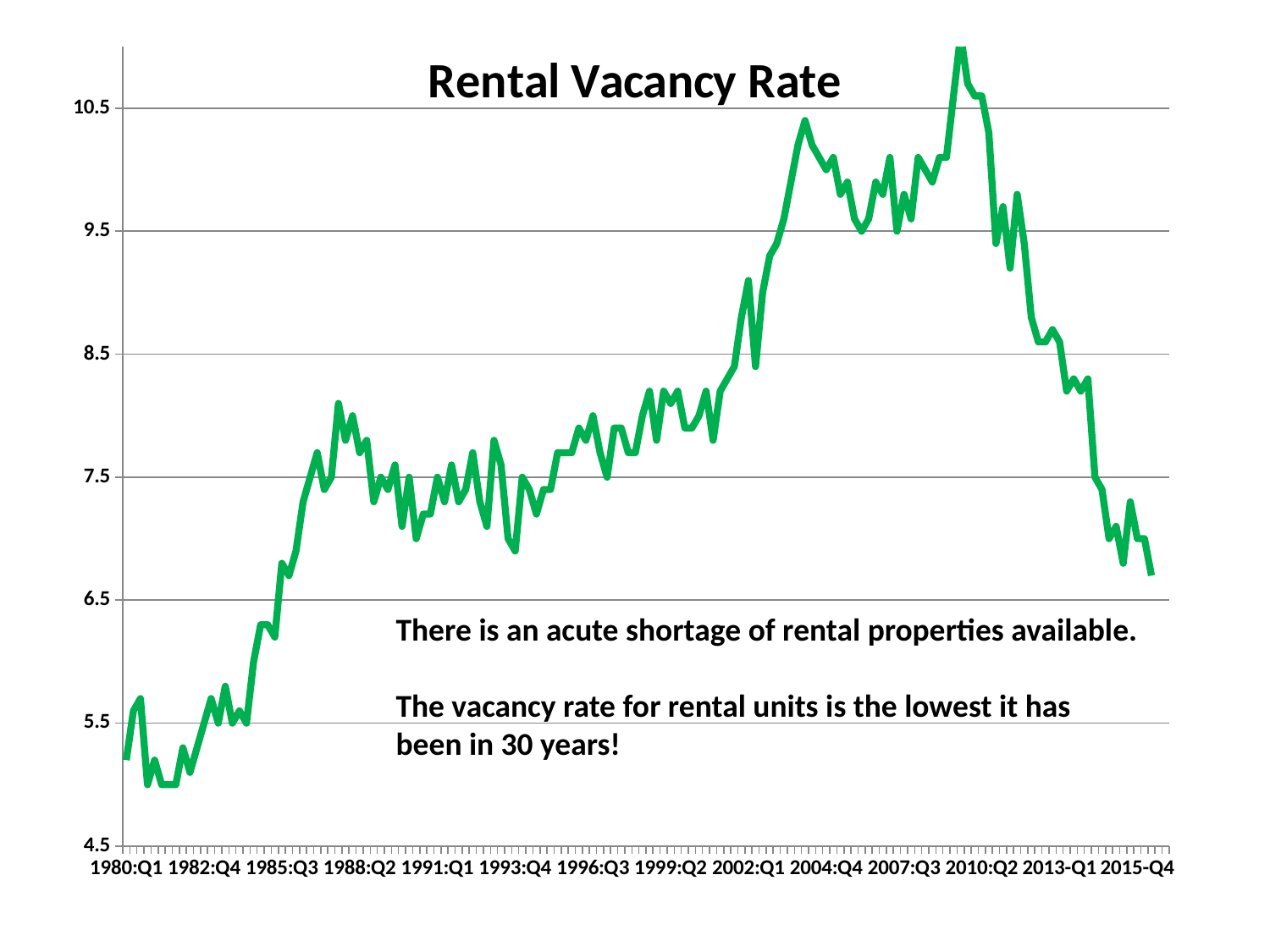
Is the value at 1980:Q1 greater or less than 5.5? less What is the title of the chart? Rental Vacancy Rate Is the value at 2002:Q1 greater or less than 8.5? greater Is the value at 2004:Q4 greater or less than 9.5? greater Near which x-axis label does the line reach its highest value? 2010:Q2 How many labels are shown on the x axis of the chart? 14 What colour is the line in the chart? green Does the rental vacancy rate rise or fall between 2010:Q2 and 2015-Q4? fall What kind of chart is shown on the slide? line chart